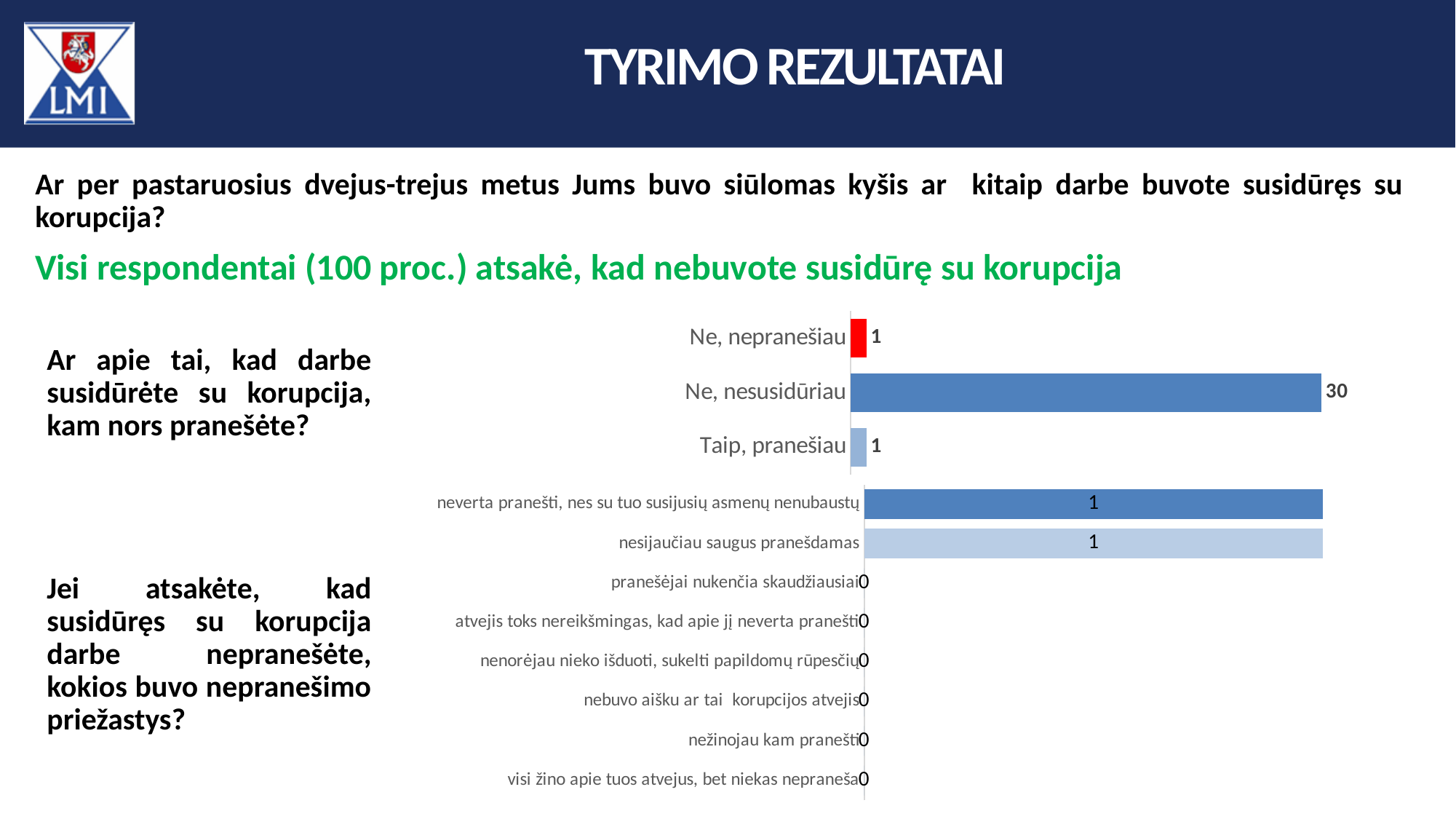
In the upper chart, what colour is the bar for "Ne, nepranešiau"? Red In the lower chart, which is larger: "neverta pranešti, nes su tuo susijusių asmenų nenubaustų" or "pranešėjai nukenčia skaudžiausiai"? neverta pranešti, nes su tuo susijusių asmenų nenubaustų In the lower chart, what is the value for "nesijaučiau saugus pranešdamas"? 1 What kind of chart is the upper chart? Bar chart In the upper chart, what is the value for "Taip, pranešiau"? 1 How many categories does the upper chart show? 3 In the upper chart, which category has the highest value? Ne, nesusidūriau In the upper chart, what is the value for "Ne, nesusidūriau"? 30 In the lower chart, what is the value for "nežinojau kam pranešti"? 0 In the upper chart, what is the value for "Ne, nepranešiau"? 1 In the upper chart, what is the difference between "Ne, nesusidūriau" and "Taip, pranešiau"? 29 How many categories does the lower chart show? 8